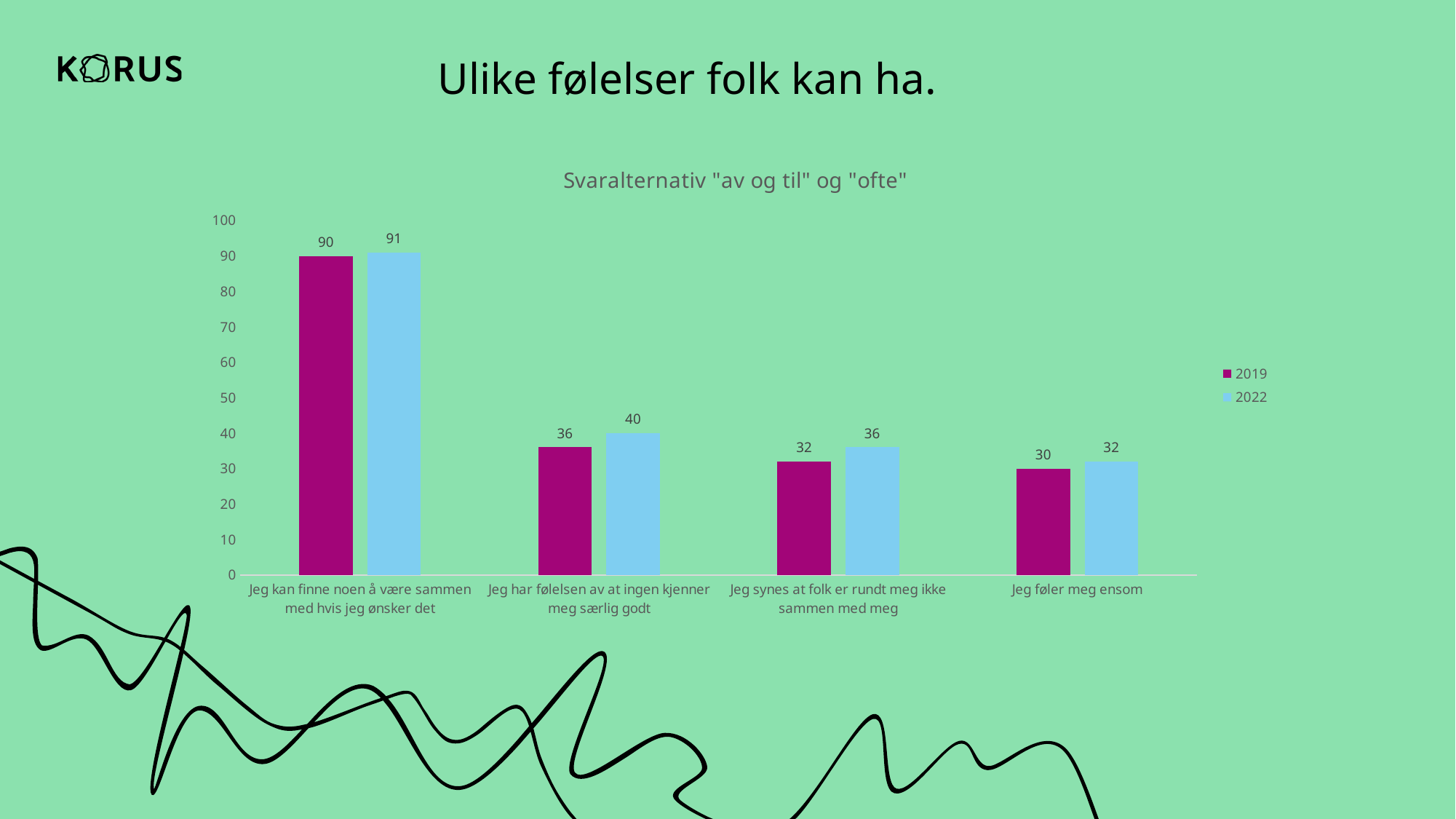
What is the difference between the 2022 and 2019 values for "Jeg har følelsen av at ingen kjenner meg særlig godt"? 4 What is the title of the chart? Svaralternativ "av og til" og "ofte" How many categories are shown on the x axis? 4 What kind of chart is shown on the slide? Bar chart Which category has the lowest 2019 value? Jeg føler meg ensom Which is larger for "Jeg synes at folk er rundt meg ikke sammen med meg": the 2019 value or the 2022 value? 2022 How many series does the legend list? 2 What is the 2019 value for "Jeg kan finne noen å være sammen med hvis jeg ønsker det"? 90 What is the 2019 value for "Jeg føler meg ensom"? 30 What is the 2022 value for "Jeg har følelsen av at ingen kjenner meg særlig godt"? 40 Which category has the highest 2022 value? Jeg kan finne noen å være sammen med hvis jeg ønsker det What is the 2022 value for "Jeg synes at folk er rundt meg ikke sammen med meg"? 36